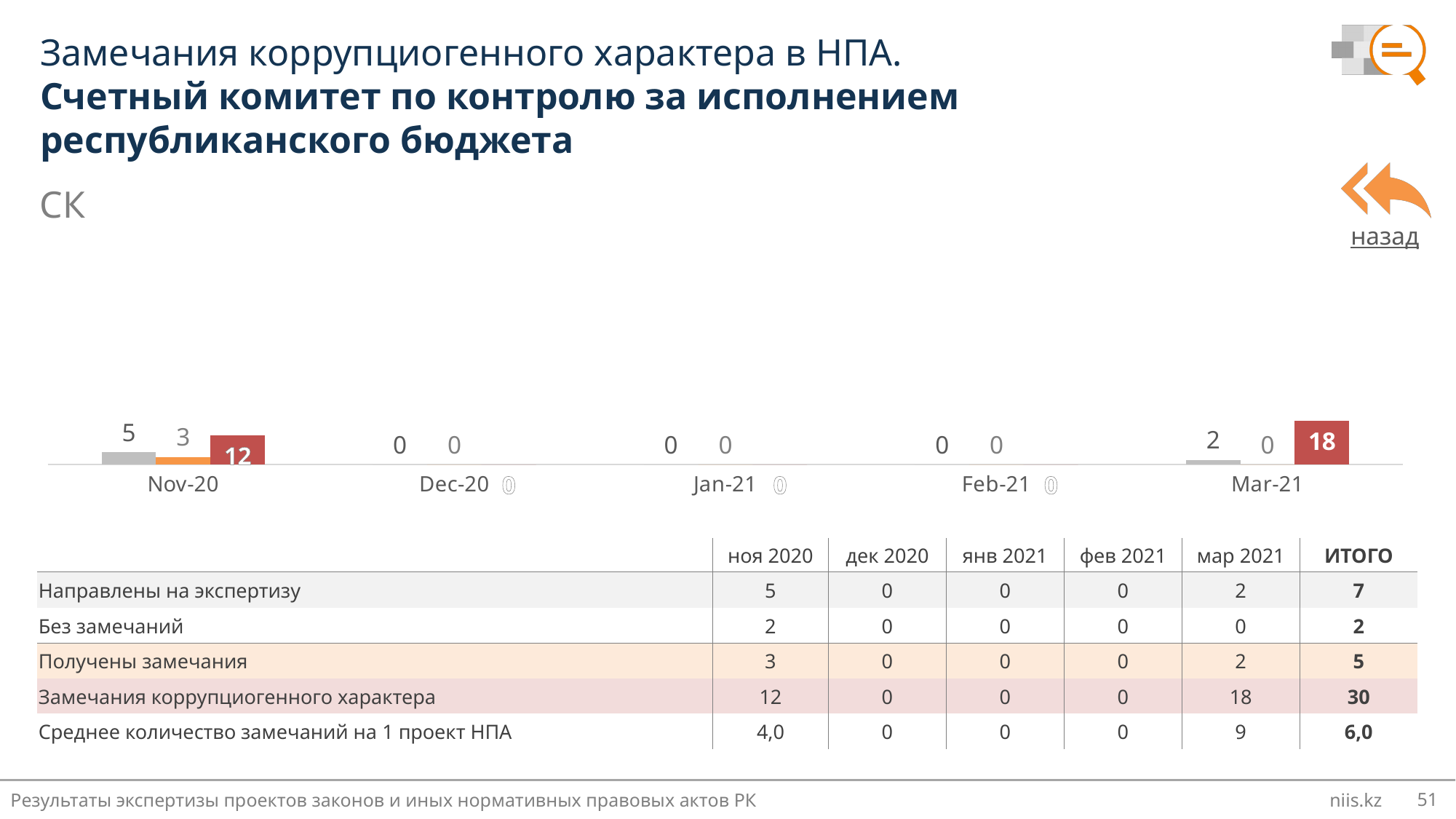
What is the value of the red bar for Mar-21? 18 What is the value of the orange bar for Nov-20? 3 What type of chart is shown on the slide? bar chart What is the value of the red bar for Nov-20? 12 What is the difference between the red bar values for Mar-21 and Nov-20? 6 What is the difference between the grey and orange bar values for Nov-20? 2 Which month has the highest red bar? Mar-21 How many months are shown on the x axis of the chart? 5 What is the value of the grey bar for Mar-21? 2 Which is larger, the grey bar for Nov-20 or the grey bar for Mar-21? Nov-20 What is the value of the grey bar for Dec-20? 0 What is the value of the grey bar for Nov-20? 5